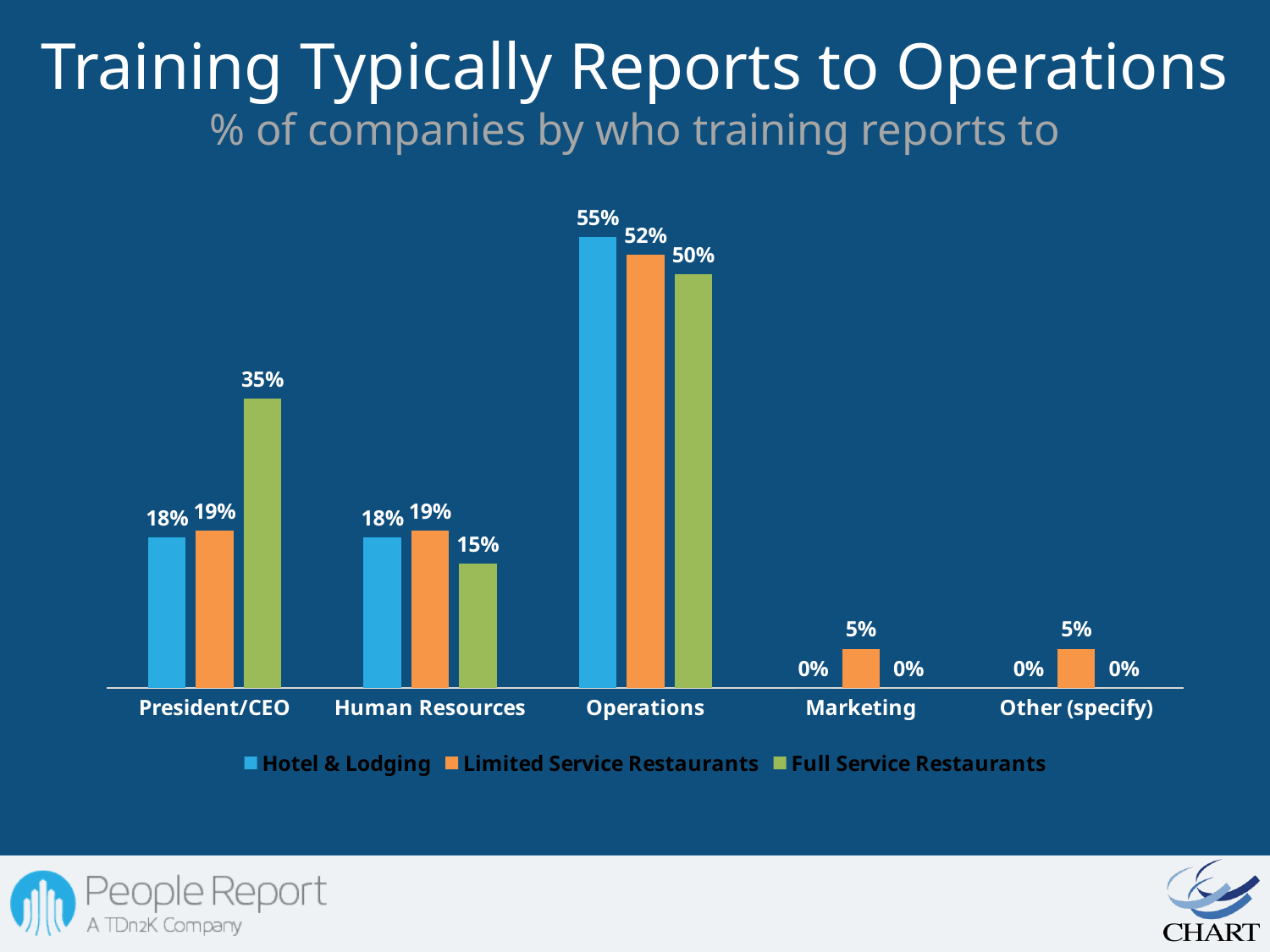
In the President/CEO category, which is larger: Full Service Restaurants or Hotel & Lodging? Full Service Restaurants What is the value for Full Service Restaurants in the President/CEO category? 35% What percentage of Hotel & Lodging companies have training report to Operations? 55% What is the value for Limited Service Restaurants in the Marketing category? 5% Which category has the lowest value for Full Service Restaurants? Marketing and Other (specify) What is the subtitle of the chart? % of companies by who training reports to How many series does the legend list? 3 What is the difference between the Hotel & Lodging and Full Service Restaurants values for Operations? 5% What is the value for Full Service Restaurants in the Human Resources category? 15% Which category has the highest value for Limited Service Restaurants? Operations How many categories are shown on the x axis? 5 What kind of chart is shown on the slide? Bar chart